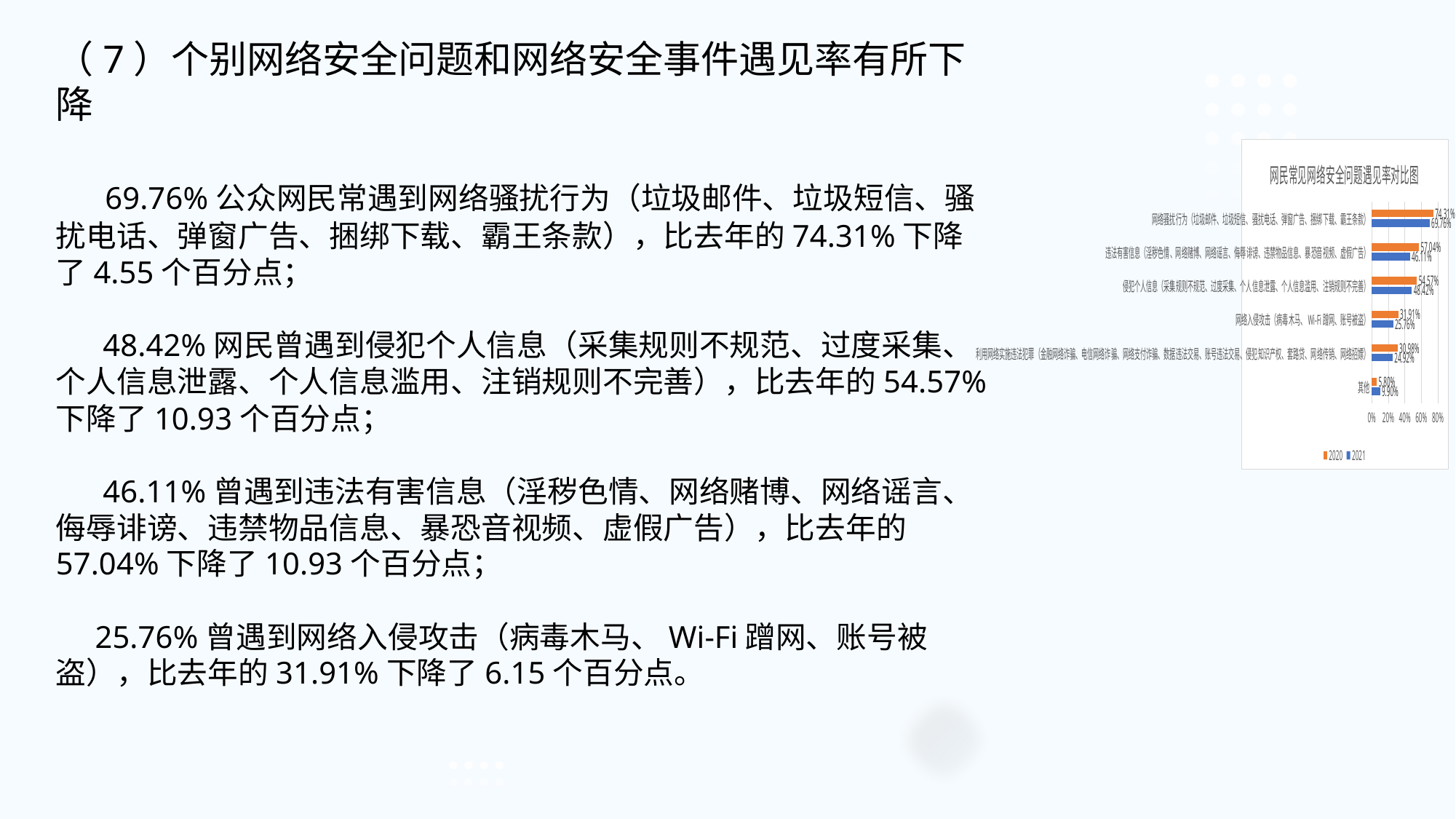
What is the 2020 value for 侵犯个人信息 in the chart? 54.57% What is the difference between the 2020 and 2021 values for 违法有害信息 in the chart? 10.93 percentage points What is the 2021 value for 网络入侵攻击 in the chart? 25.76% Which category has the lowest 2021 value in the chart? 其他 For 其他, which is larger in the chart: the 2020 value or the 2021 value? 2021 Which category has the highest 2020 value in the chart? 网络骚扰行为 What kind of chart is shown on the slide? bar chart What is the 2021 value for 网络骚扰行为 in the chart? 69.76% Is the 2021 value for 侵犯个人信息 greater or less than 40%? greater How many series does the chart's legend list? 2 What is the title of the chart on the slide? 网民常见网络安全问题遇见率对比图 How many categories are plotted in the chart? 6